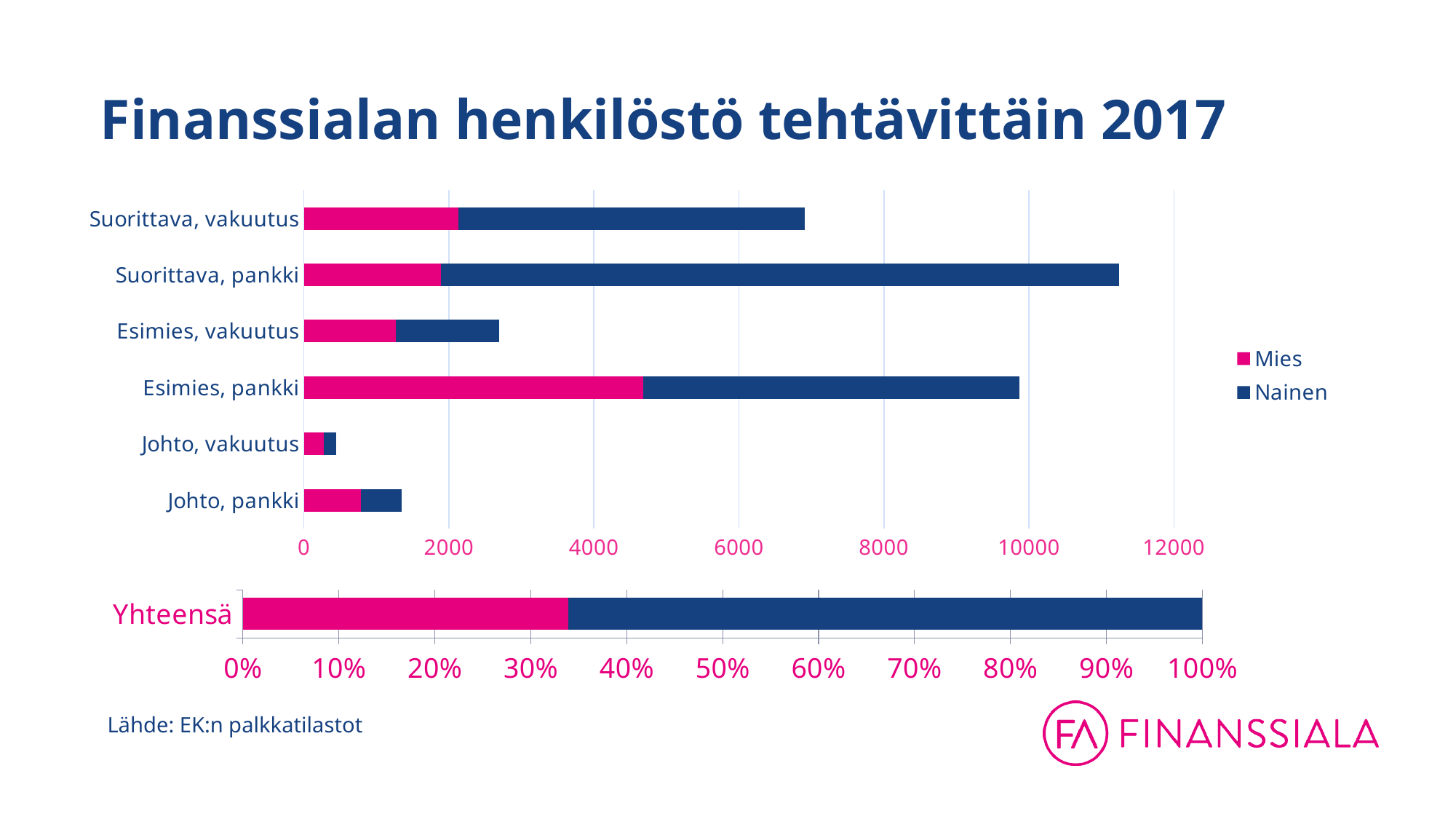
In the top chart, which category has the shortest total bar? Johto, vakuutus In the bottom Yhteensä chart, which series takes the larger share: Mies or Nainen? Nainen In the top chart, which category has the longest total bar? Suorittava, pankki What kind of chart is the top chart on the slide? bar chart In the top chart, which category has the larger Mies segment: Esimies, pankki or Suorittava, vakuutus? Esimies, pankki In the top chart, which has the longer total bar: Esimies, pankki or Suorittava, vakuutus? Esimies, pankki How many series does the legend of the top chart list? 2 How many categories are shown on the vertical axis of the top chart? 6 In the top chart, is the total bar for Esimies, vakuutus greater or less than 4000? less What are the two legend entries of the top chart? Mies, Nainen In the bottom Yhteensä chart, is the Mies share greater or less than 40%? less In the top chart, is the total bar for Suorittava, pankki greater or less than 10000? greater